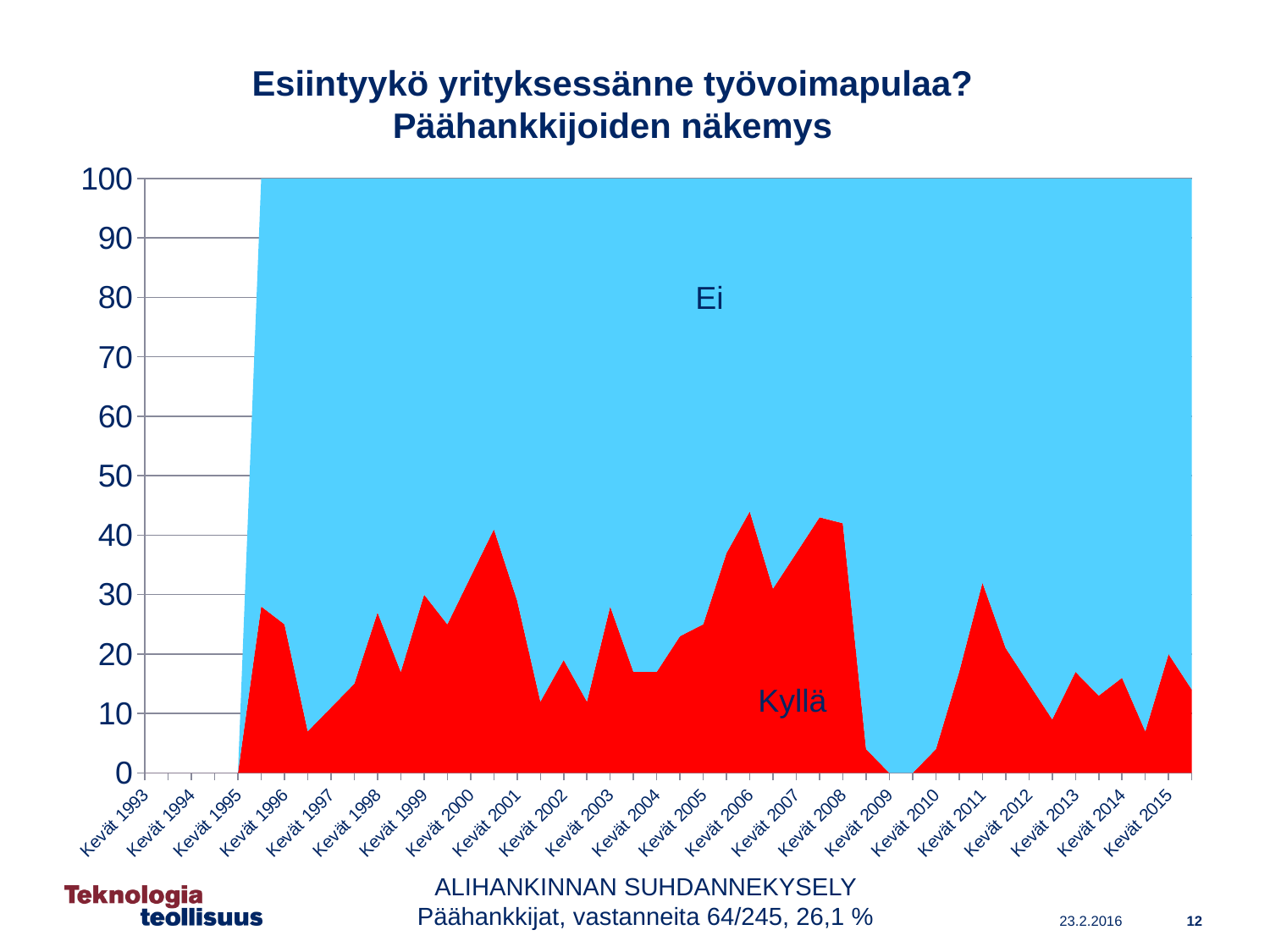
Which series is drawn in red? Kyllä Which is larger, the Kyllä value for Kevät 2000 or for Kevät 2002? Kevät 2000 How many time points are labelled on the x axis? 23 Is the Kyllä value for Kevät 2009 greater or less than 10? less Does the Kyllä value rise or fall from Kevät 2008 to Kevät 2009? Fall Is the Kyllä value for Kevät 2006 greater or less than 40? greater Is the Kyllä value for Kevät 1997 greater or less than 20? less What are the names of the two series shown in the chart? Ei and Kyllä How many series are plotted in the chart? 2 What kind of chart is shown on the slide? Area chart Does the Kyllä value rise or fall from Kevät 2009 to Kevät 2011? Rise